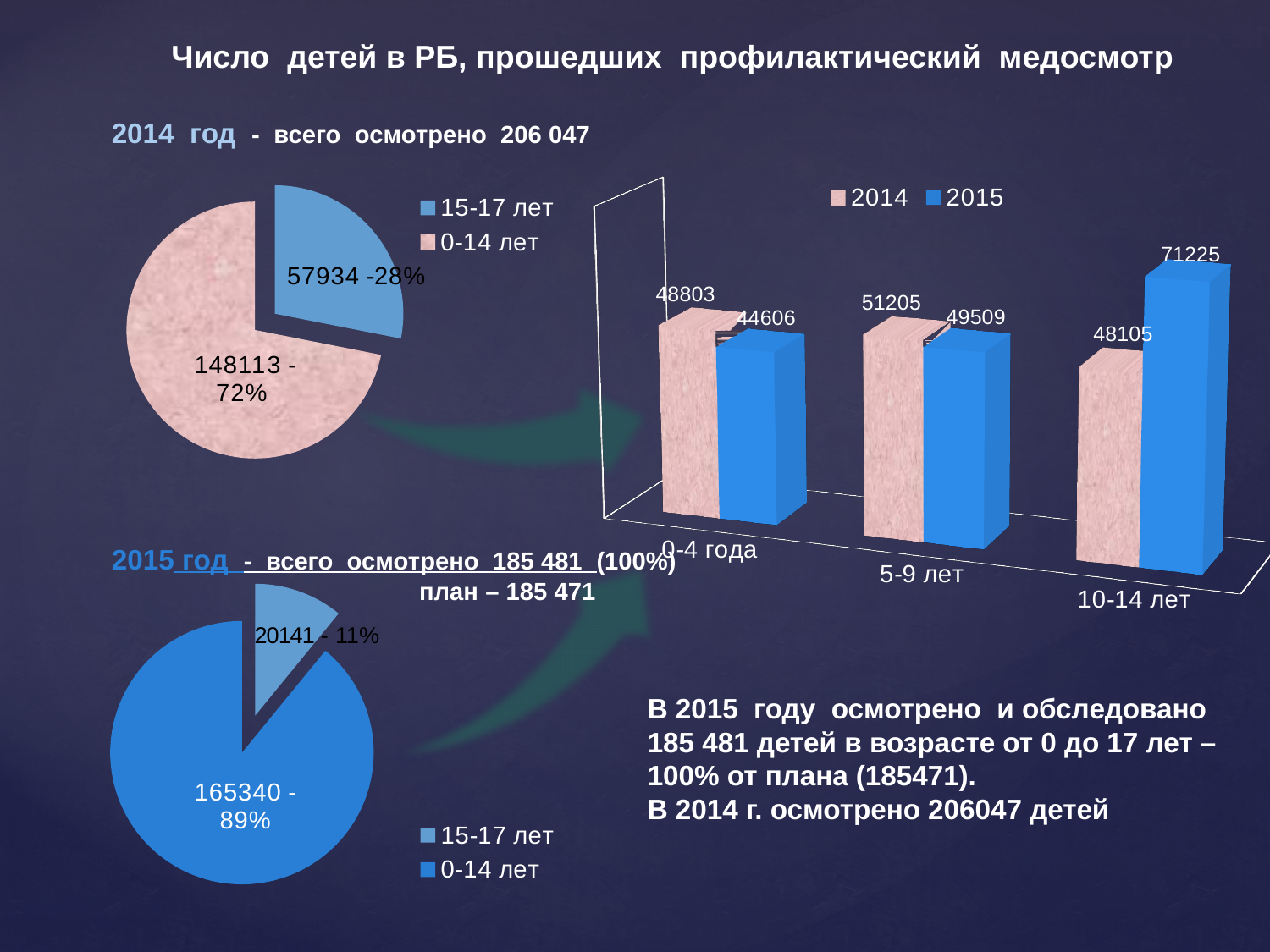
In the bar chart on the right, what is the 2015 value for the 10-14 лет age group? 71225 In the bar chart on the right, which age group has the lowest 2014 value? 10-14 лет In the bar chart on the right, how many series does the legend list? 2 What type of chart is the chart on the right of the slide? bar chart In the bottom-left pie chart (2015 год), what share of the pie is the 15-17 лет slice? 11% In the bar chart on the right, which age group has the highest 2015 value? 10-14 лет In the bar chart on the right, what is the 2014 value for the 5-9 лет age group? 51205 In the bottom-left pie chart (2015 год), what is the value for the 0-14 лет slice? 165340 In the bar chart on the right, what is the difference between the 2015 and 2014 values for the 10-14 лет age group? 23120 In the bar chart on the right, how many age groups are shown? 3 In the top-left pie chart (2014 год), what share of the pie is the 15-17 лет slice? 28% In the bar chart on the right, for the 0-4 года age group, which year has the larger value, 2014 or 2015? 2014